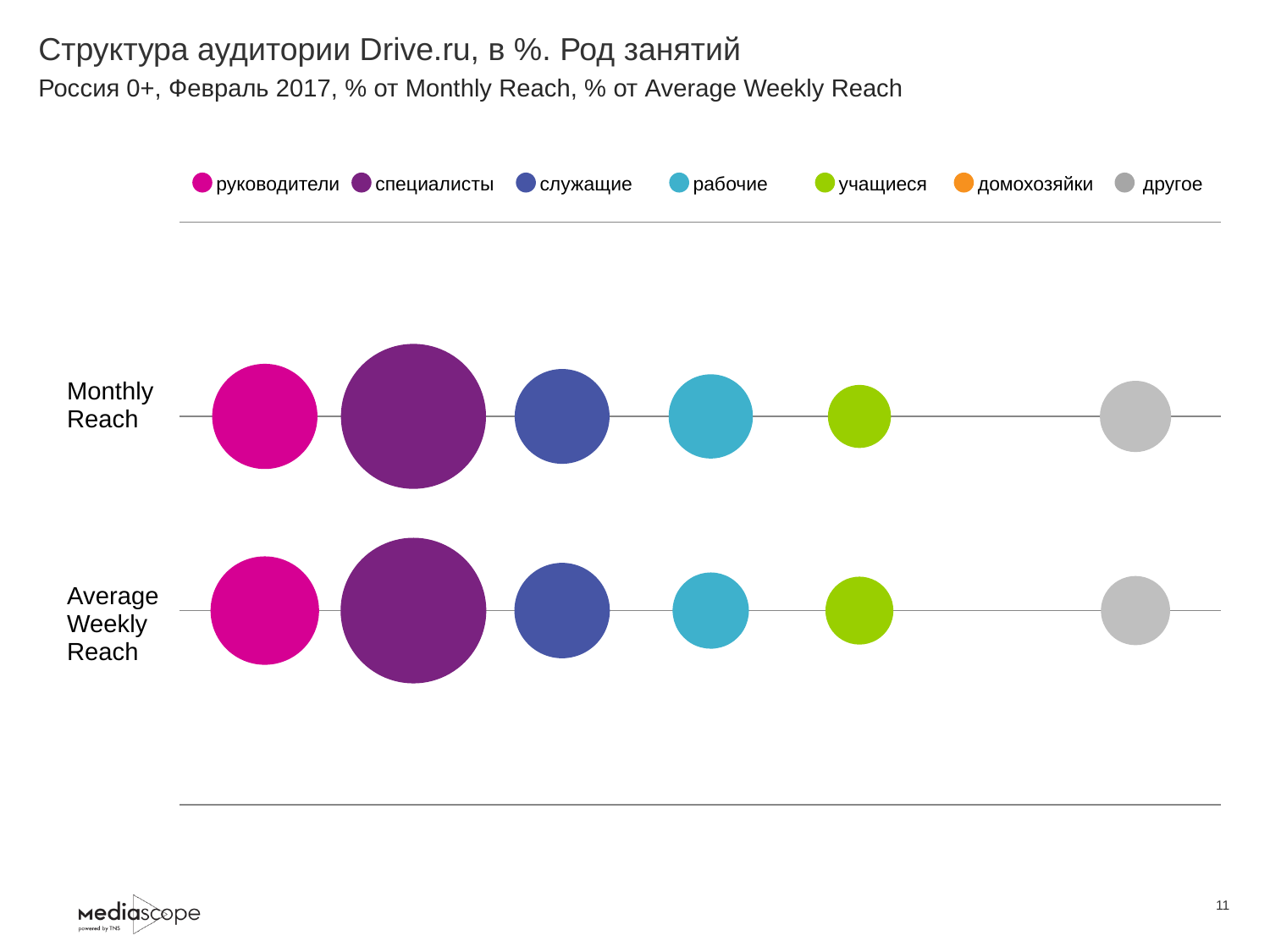
How many rows (categories) are plotted on the chart? 2 Which occupation group has the largest bubble in the Average Weekly Reach row? специалисты How many series does the legend list? 7 In the Monthly Reach row, which bubble is larger: руководители or служащие? руководители What is the title of the chart on the slide? Структура аудитории Drive.ru, в %. Род занятий Which occupation group has the largest bubble in the Monthly Reach row? специалисты In the Average Weekly Reach row, which bubble is larger: специалисты or рабочие? специалисты In the Monthly Reach row, which bubble is larger: служащие or учащиеся? служащие Which legend entry is shown in grey? другое What are the labels of the two rows plotted on the chart? Monthly Reach and Average Weekly Reach What kind of chart is shown on the slide? Bubble chart